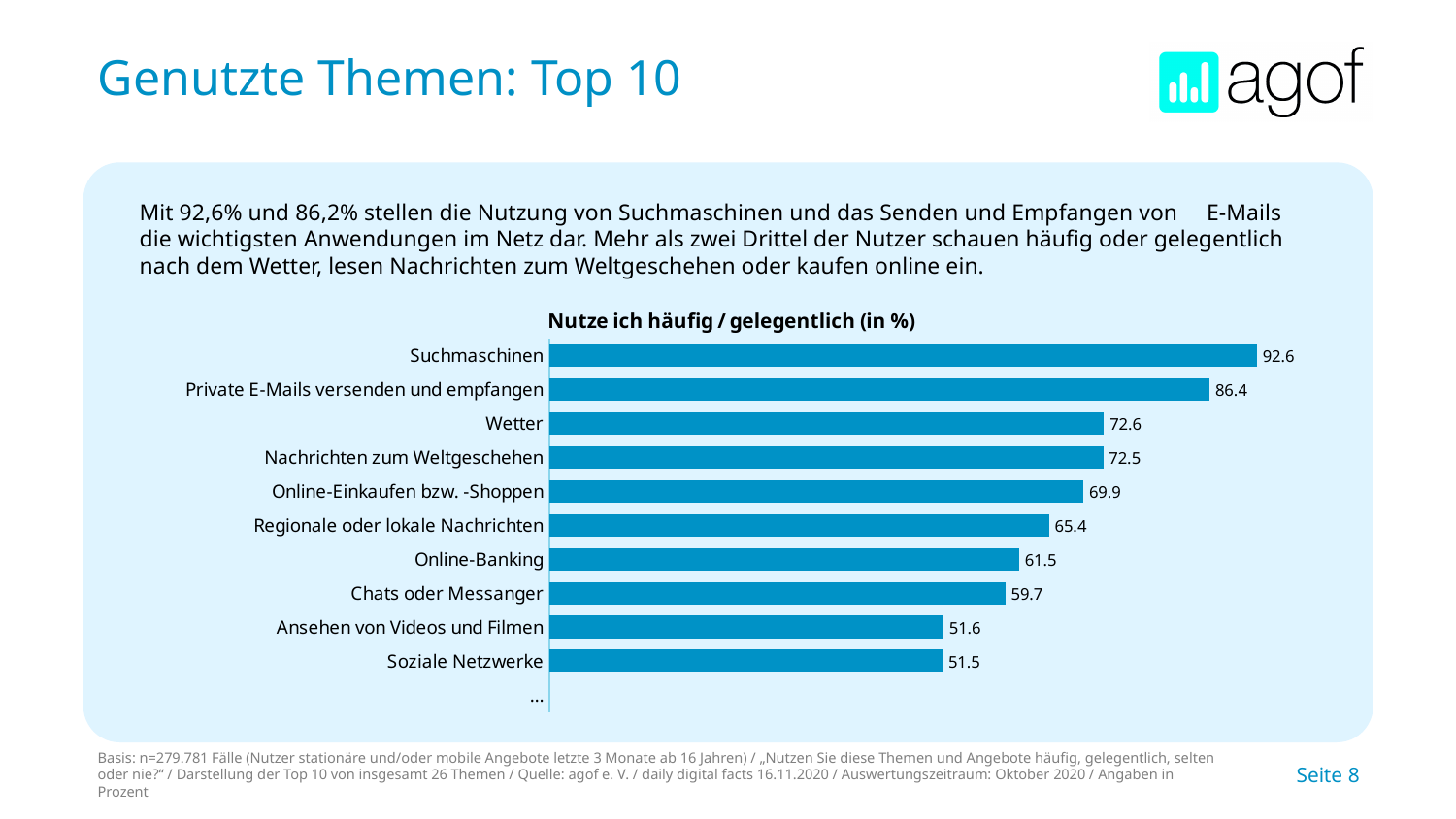
Which is larger, the value for Online-Einkaufen bzw. -Shoppen or the value for Online-Banking? Online-Einkaufen bzw. -Shoppen How many labelled categories have bars in the chart? 10 What value is shown for Online-Banking? 61.5 What is the difference between the values for Suchmaschinen and Private E-Mails versenden und empfangen? 6.2 Which category has the highest value? Suchmaschinen What kind of chart is shown on the slide? Bar chart What value is shown for Suchmaschinen? 92.6 What value is shown for Chats oder Messanger? 59.7 What value is shown for Regionale oder lokale Nachrichten? 65.4 What is the difference between the values for Wetter and Nachrichten zum Weltgeschehen? 0.1 Which category has the lowest value among the labelled bars? Soziale Netzwerke What is the title of the chart? Nutze ich häufig / gelegentlich (in %)